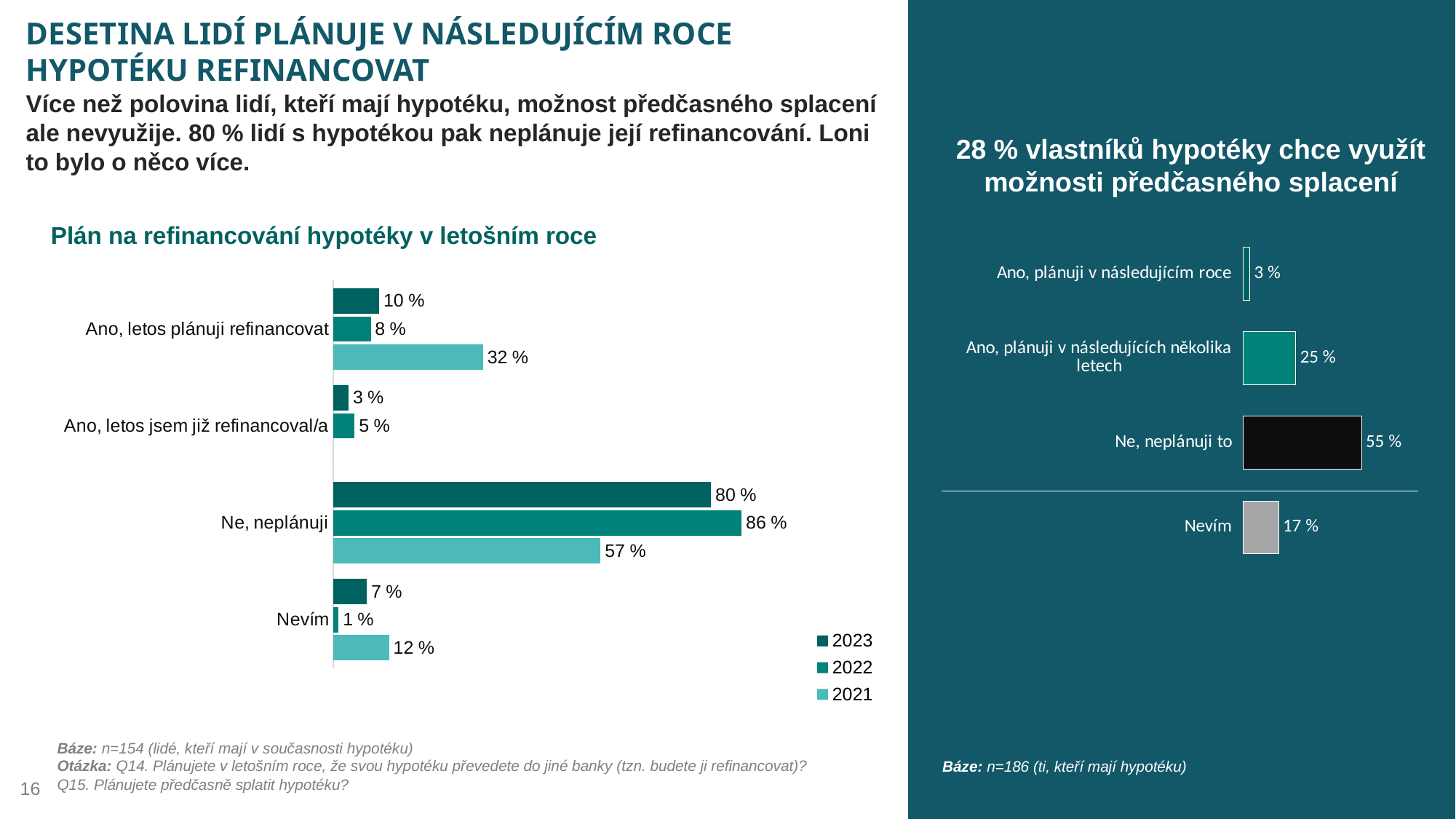
What kind of chart is the chart on the right side of the slide? Bar chart In the chart 'Plán na refinancování hypotéky v letošním roce', which is larger for 'Ano, letos jsem již refinancoval/a': the 2023 value or the 2022 value? 2022 In the chart 'Plán na refinancování hypotéky v letošním roce', which year has the highest value for 'Ne, neplánuji'? 2022 How many categories are shown in the chart on the right side of the slide? 4 In the chart 'Plán na refinancování hypotéky v letošním roce', what is the 2021 value for 'Ano, letos plánuji refinancovat'? 32 % In the chart on the right side of the slide, what is the value for 'Ano, plánuji v následujících několika letech'? 25 % In the chart 'Plán na refinancování hypotéky v letošním roce', what is the 2023 value for 'Ne, neplánuji'? 80 % In the chart on the right side of the slide, which category has the lowest value? Ano, plánuji v následujícím roce In the chart 'Plán na refinancování hypotéky v letošním roce', what is the difference between the 2022 and 2023 values for 'Ne, neplánuji'? 6 % In the chart on the right side of the slide, what is the value for 'Ne, neplánuji to'? 55 % In the chart 'Plán na refinancování hypotéky v letošním roce', how many series does the legend list? 3 In the chart 'Plán na refinancování hypotéky v letošním roce', what is the 2022 value for 'Nevím'? 1 %